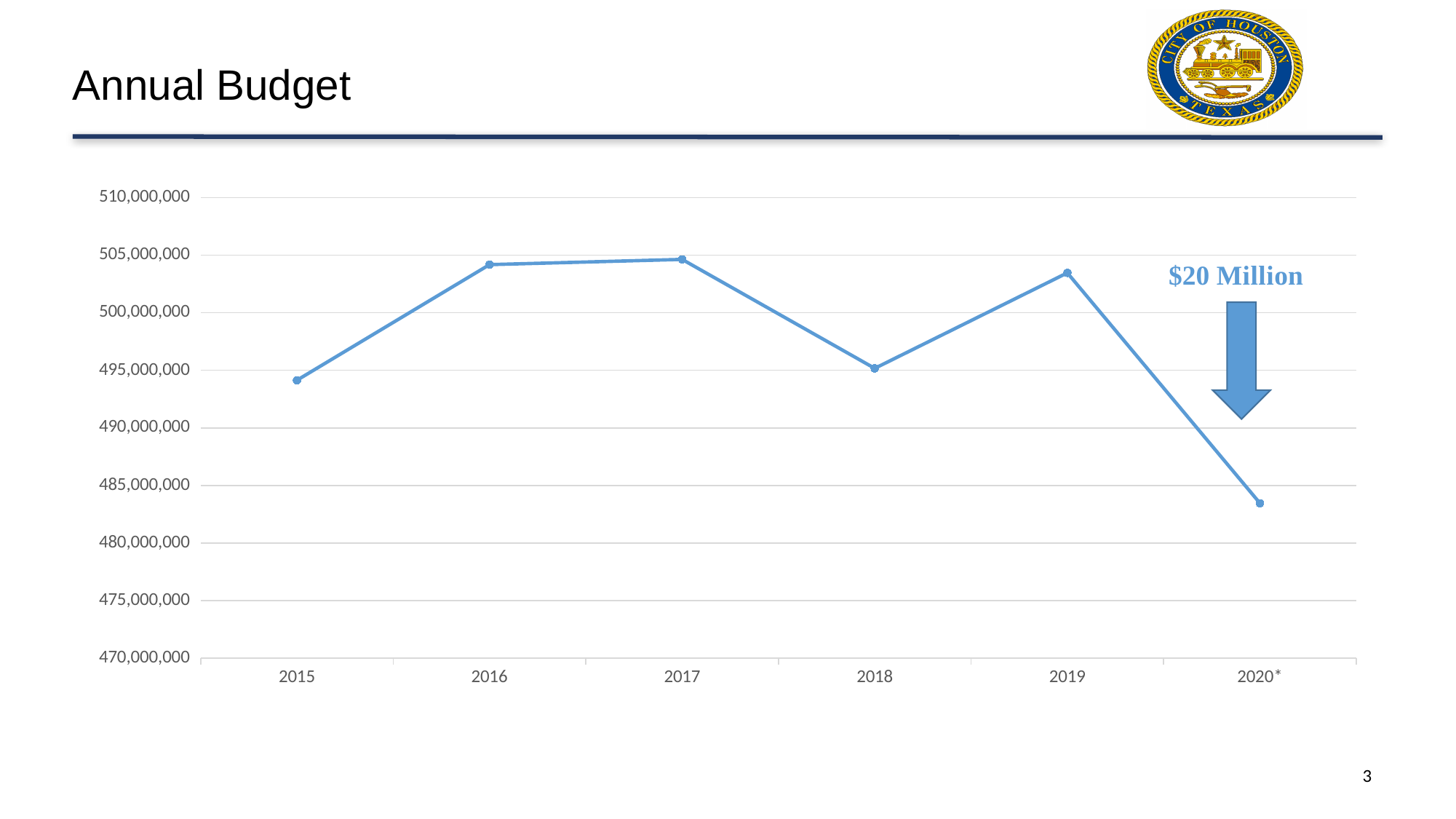
What kind of chart is shown on the slide? line chart Is the value for 2015 greater or less than 495,000,000? less Is the value for 2019 greater or less than 500,000,000? greater What is the title of the slide containing the chart? Annual Budget Is the value for 2018 greater or less than 500,000,000? less Does the value rise or fall from 2019 to 2020*? fall Which is larger, the value for 2019 or the value for 2018? 2019 What amount is written next to the downward arrow on the chart? $20 Million How many years are plotted on the x axis of the chart? 6 Which year has the lowest value on the chart? 2020*